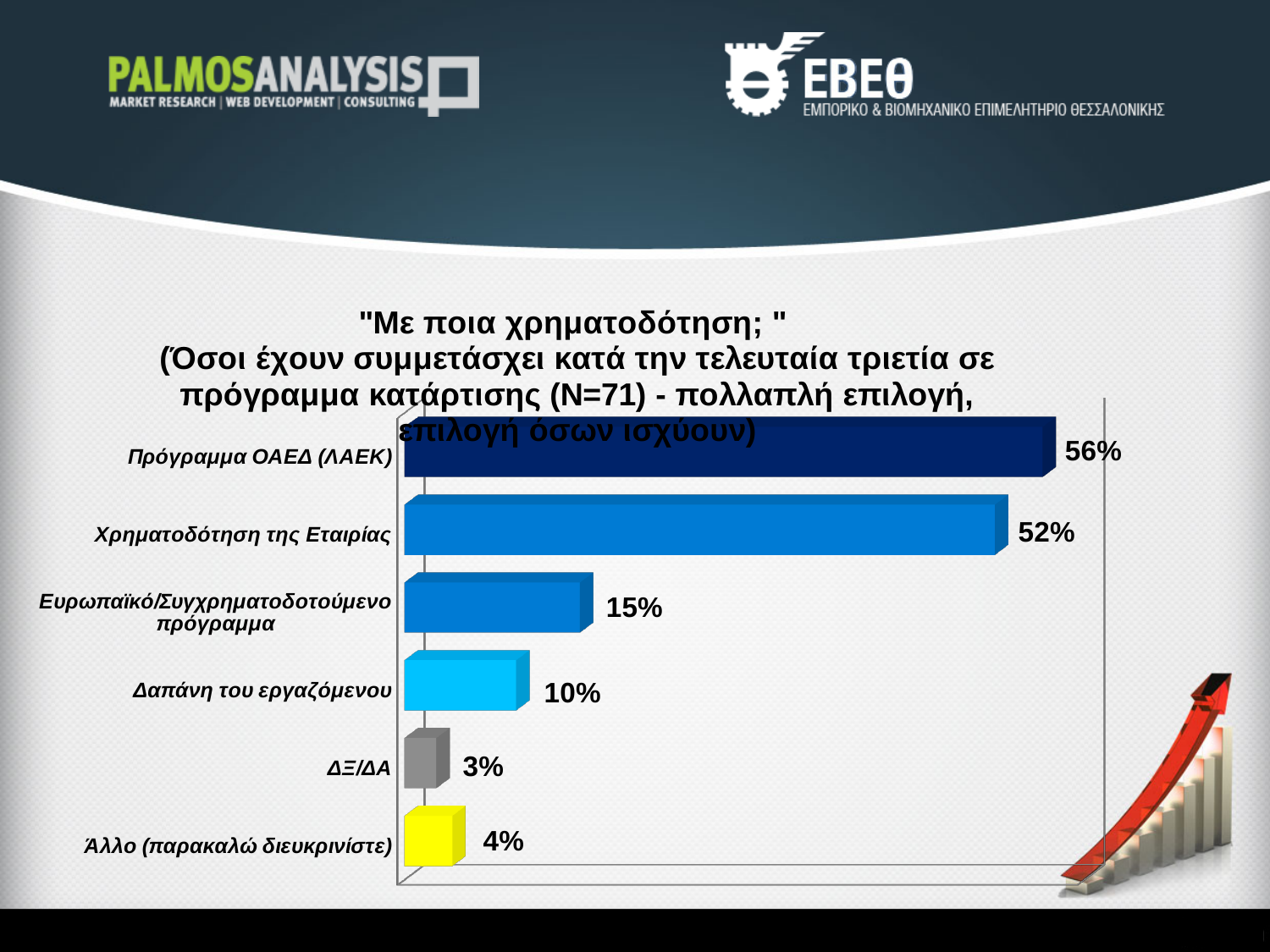
What is the value for Πρόγραμμα ΟΑΕΔ (ΛΑΕΚ)? 56% Which category has the highest value? Πρόγραμμα ΟΑΕΔ (ΛΑΕΚ) How many categories are shown in the chart? 6 What is the value for Δαπάνη του εργαζόμενου? 10% Which category has the lowest value? ΔΞ/ΔΑ Which is larger, the value for Δαπάνη του εργαζόμενου or the value for Ευρωπαϊκό/Συγχρηματοδοτούμενο πρόγραμμα? Ευρωπαϊκό/Συγχρηματοδοτούμενο πρόγραμμα What is the value for ΔΞ/ΔΑ? 3% What is the difference between the values for Πρόγραμμα ΟΑΕΔ (ΛΑΕΚ) and Χρηματοδότηση της Εταιρίας? 4% What is the value for Άλλο (παρακαλώ διευκρινίστε)? 4% What is the value for Ευρωπαϊκό/Συγχρηματοδοτούμενο πρόγραμμα? 15% What kind of chart is shown on the slide? Bar chart What is the value for Χρηματοδότηση της Εταιρίας? 52%